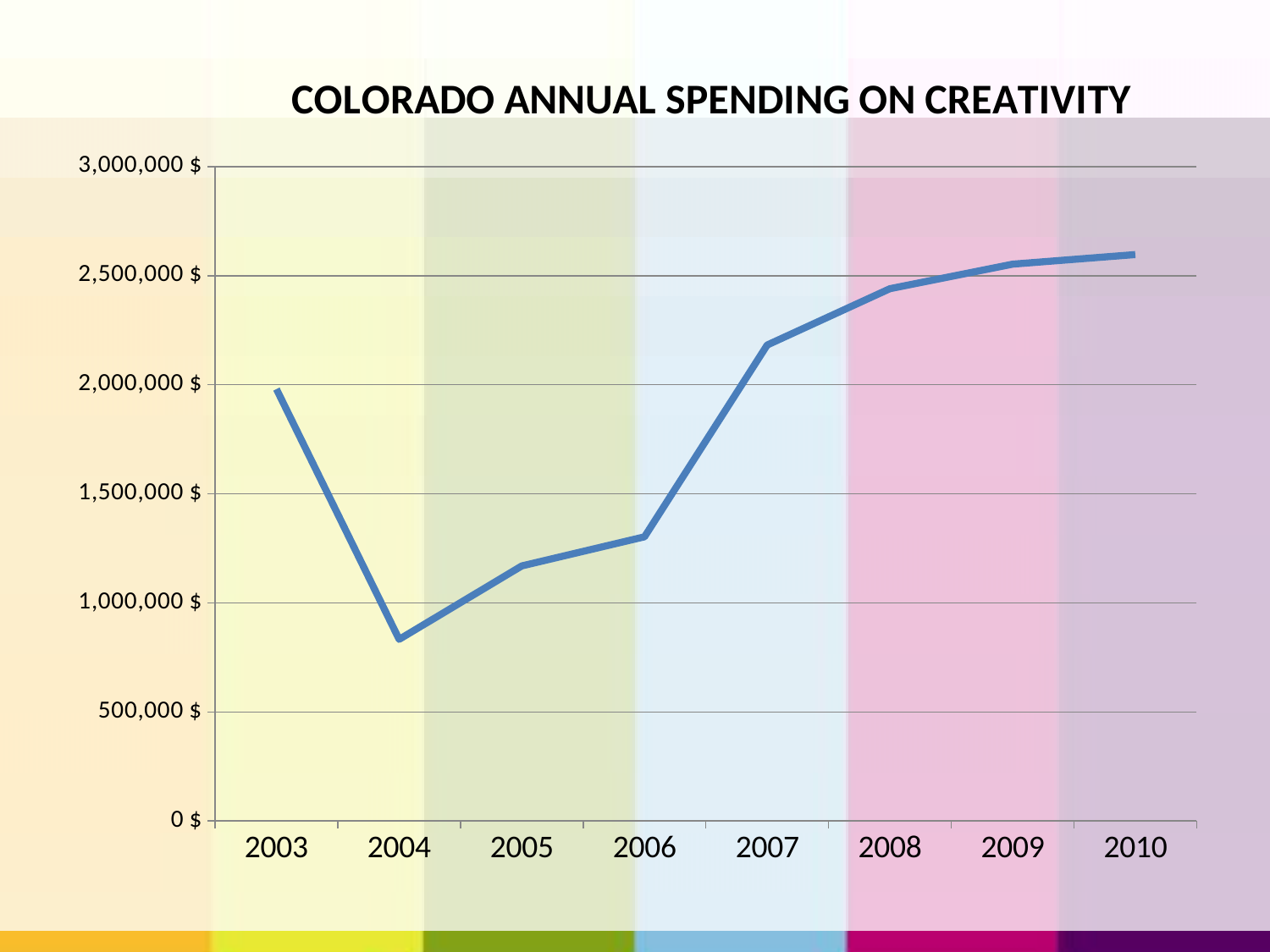
Is the value for 2010 greater or less than 2,500,000 $? greater Which is larger, the spending in 2006 or in 2007? 2007 Is the value for 2006 greater or less than 1,500,000 $? less Which year has the lowest spending? 2004 Is the value for 2004 greater or less than 1,000,000 $? less How many years are plotted on the x axis? 8 Does spending rise or fall from 2004 to 2010? rise Which is larger, the spending in 2003 or in 2005? 2003 What is the title of the chart? COLORADO ANNUAL SPENDING ON CREATIVITY What kind of chart is shown on the slide? line chart